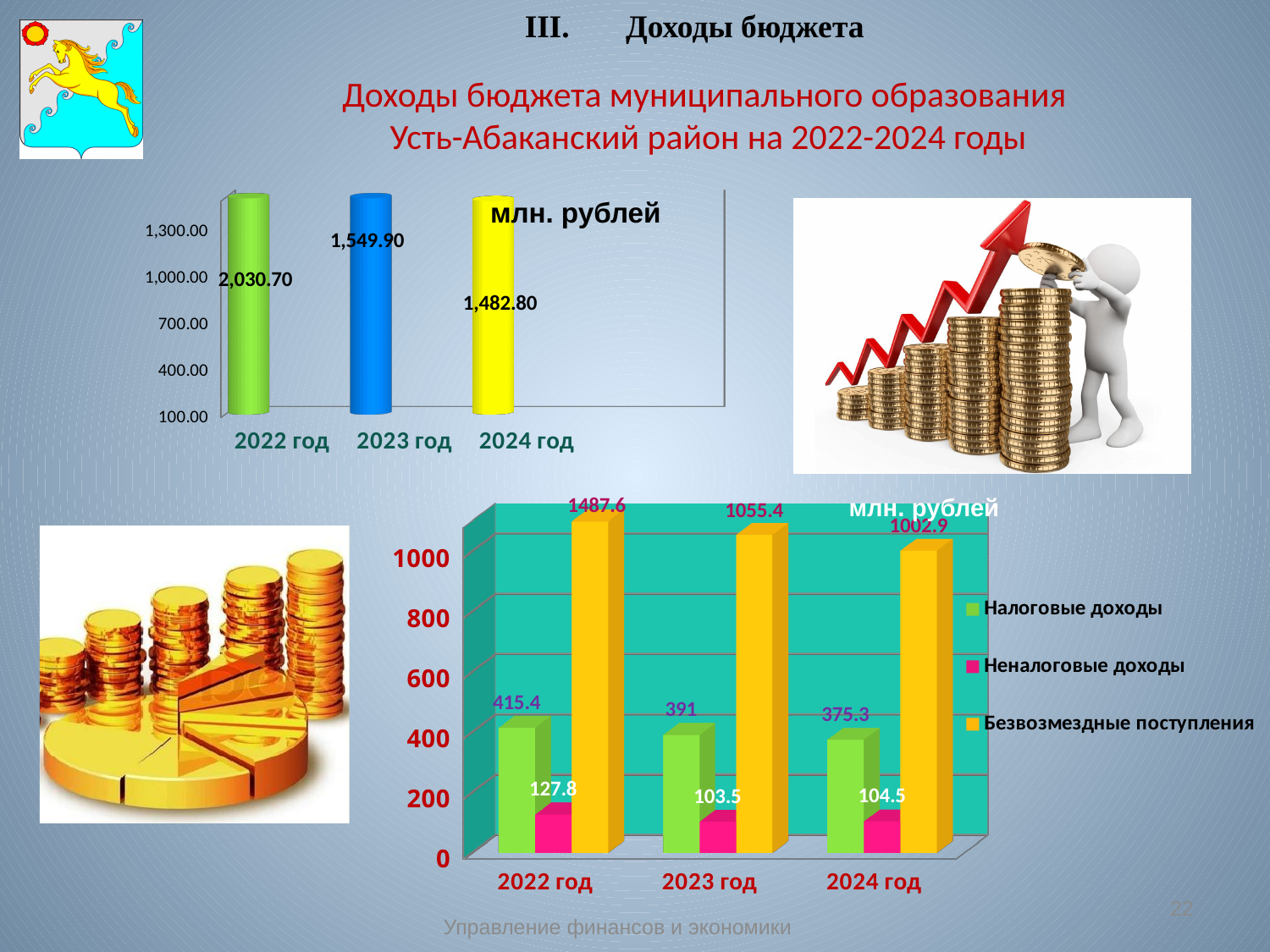
In the top chart, what unit is shown for the values? млн. рублей In the bottom chart, in which year are Безвозмездные поступления highest? 2022 год In the top chart, what is the value for 2022 год? 2,030.70 In the bottom chart, how many series does the legend list? 3 In the bottom chart, what is the difference between Налоговые доходы in 2022 год and 2024 год? 40.1 In the bottom chart, what is the value of Безвозмездные поступления for 2024 год? 1002.9 In the top chart, what is the value for 2024 год? 1,482.80 What kind of chart is the bottom chart? bar chart In the bottom chart, what is the value of Налоговые доходы for 2023 год? 391 In the top chart, what is the difference between the values for 2022 год and 2023 год? 480.80 In the top chart, which year has the highest value? 2022 год In the top chart, do the values rise or fall from 2022 год to 2024 год? fall